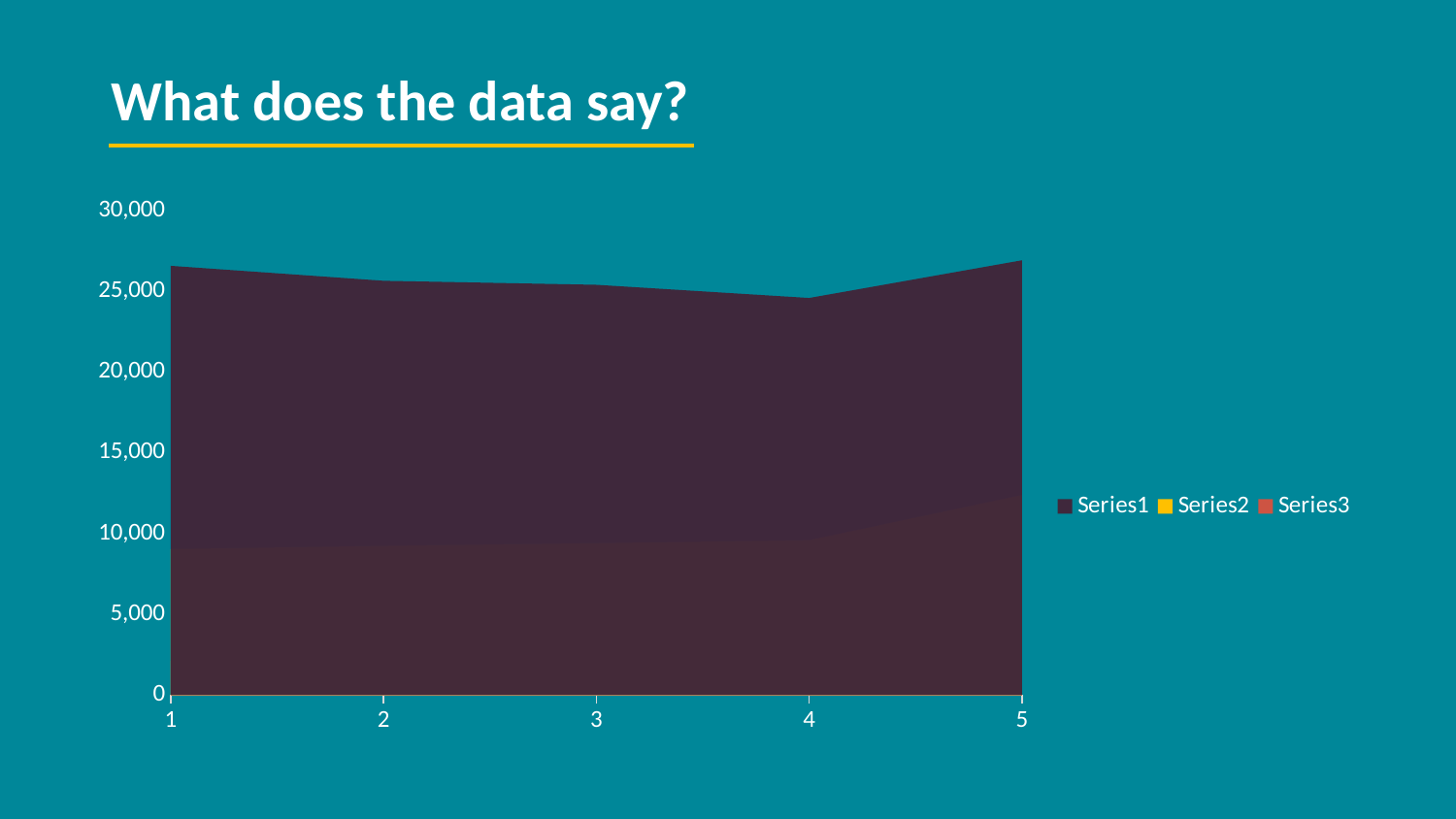
Is the top of the shaded area at x = 4 greater or less than 30,000? less At which x-axis point does the shaded area reach its highest value? 5 Is the top of the shaded area higher at x = 5 or at x = 4? 5 What kind of chart is shown on the slide? area chart Is the top of the shaded area at x = 1 greater or less than 25,000? greater What is the title of the slide containing the chart? What does the data say? Is the top of the shaded area at x = 3 greater or less than 20,000? greater At which x-axis point does the shaded area reach its lowest value? 4 How many series does the legend list? 3 What are the names of the series listed in the legend? Series1, Series2, Series3 How many points are marked along the x axis? 5